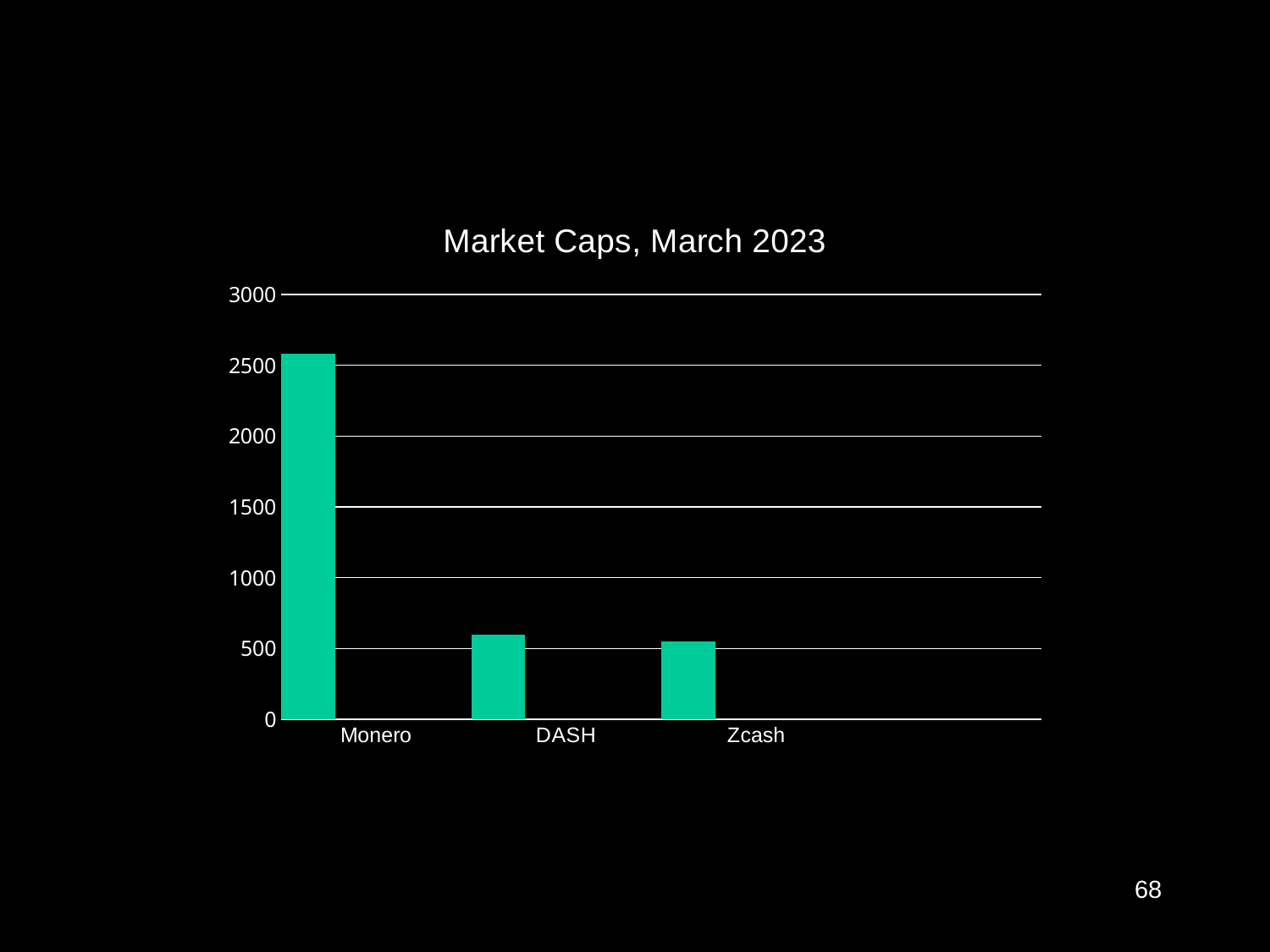
What kind of chart is shown on the slide? bar chart Do the values rise or fall moving from Monero to Zcash along the x axis? fall Is the value for DASH greater or less than 500? greater Which category has the highest market cap? Monero Which is larger, the value for Monero or the value for DASH? Monero Is the value for Monero greater or less than 2000? greater Which category has the lowest market cap? Zcash What is the title of the chart? Market Caps, March 2023 Is the value for DASH greater or less than 1000? less How many categories are plotted in the chart? 3 What is the highest value shown on the vertical axis? 3000